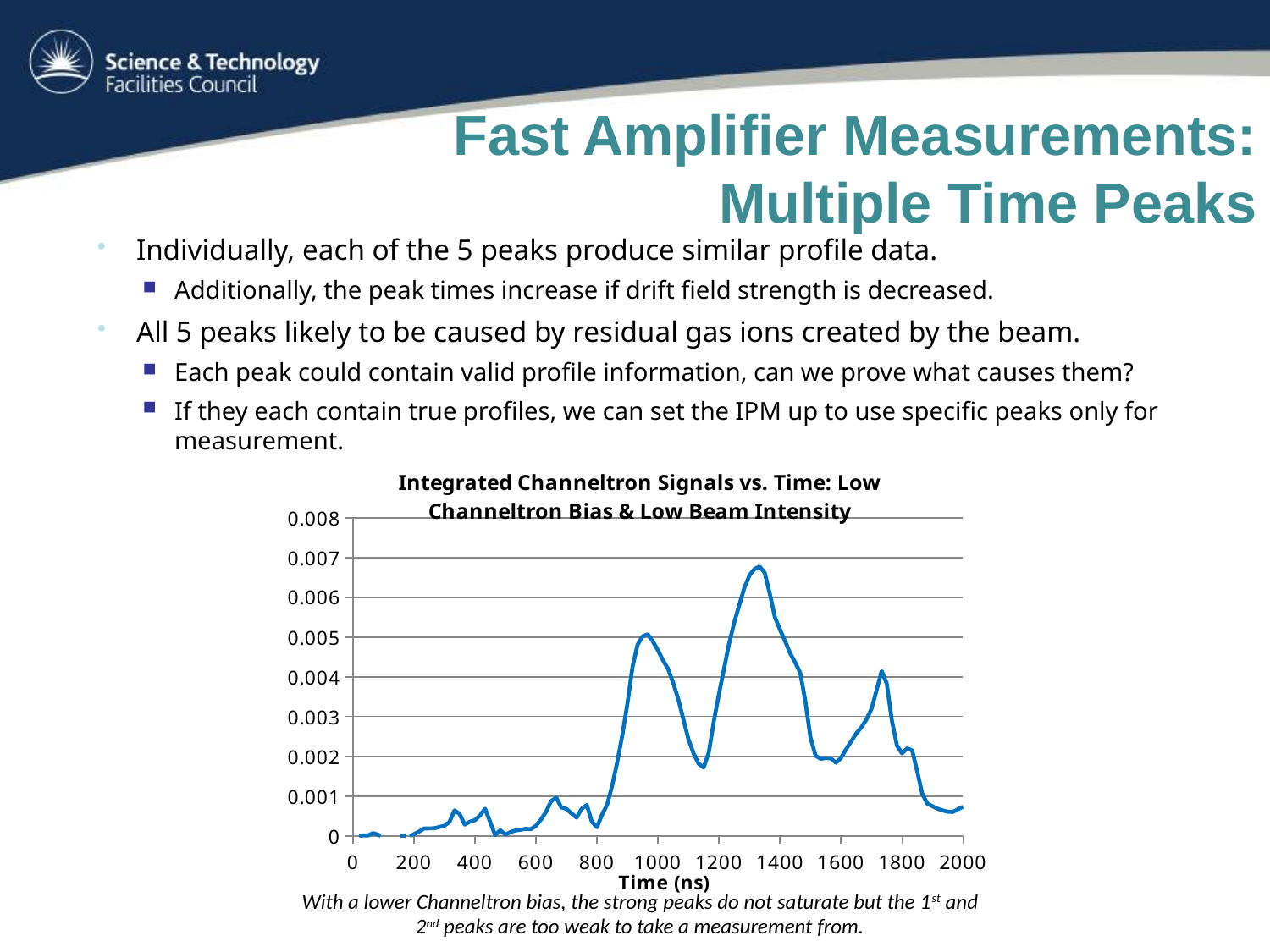
Is the value of the signal at 800 ns greater or less than 0.001? less How many lines (data series) are plotted on the chart? 1 What is the title of the chart? Integrated Channeltron Signals vs. Time: Low Channeltron Bias & Low Beam Intensity Is the value of the signal at 1600 ns greater or less than 0.003? less What is the label of the x axis of the chart? Time (ns) Does the signal rise or fall between 1800 ns and 2000 ns? fall What kind of chart is shown on the slide? line chart Which is higher, the peak near 1000 ns or the peak near 1300 ns? the peak near 1300 ns Is the highest value of the signal greater or less than 0.006? greater